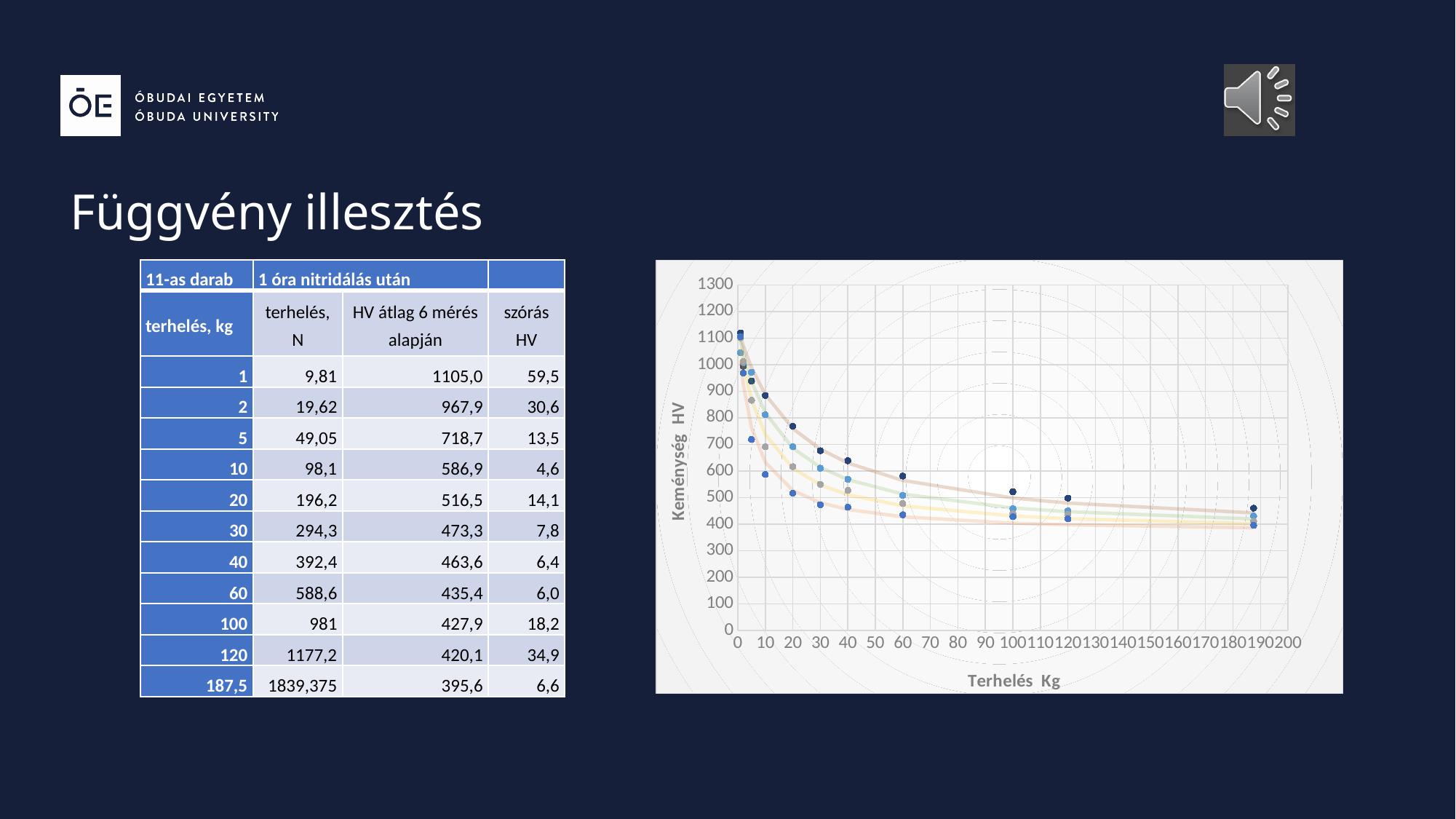
What is the title of the y axis of the chart? Keménység HV In the chart, are the plotted points at a load of 60 kg greater or less than 700 HV? less In the chart, are the plotted points at the largest load (around 187.5 kg) greater or less than 500 HV? less In the chart, is the highest plotted point at a load of 20 kg greater or less than 600 HV? greater In the chart, do the hardness (HV) values rise or fall as the load (Terhelés) increases along the x axis? fall What is the title of the x axis of the chart? Terhelés Kg What kind of chart is shown on the slide? scatter chart